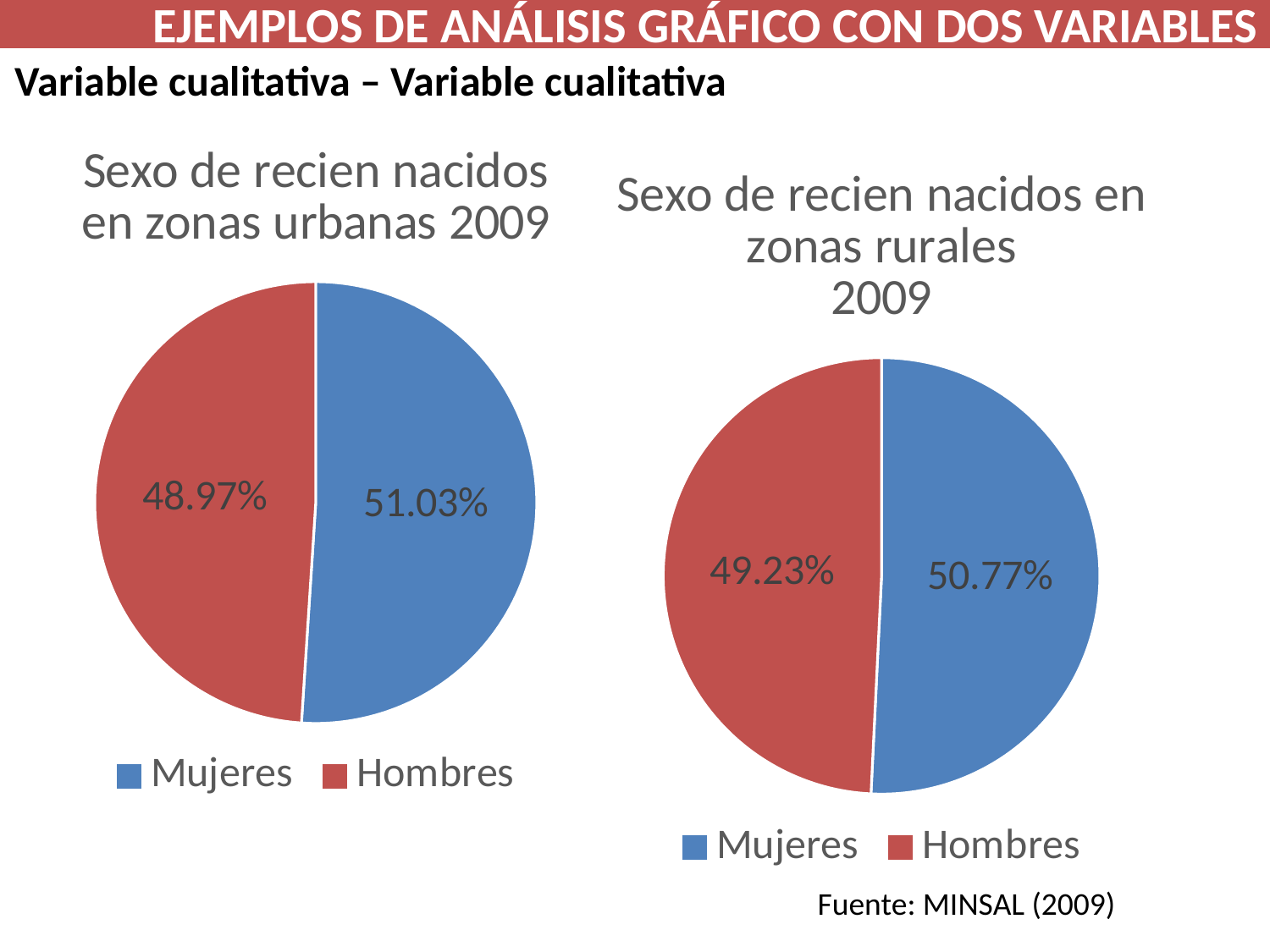
In the chart 'Sexo de recien nacidos en zonas rurales 2009', what is the difference between the Mujeres and Hombres shares? 1.54% How many categories does the legend of the chart 'Sexo de recien nacidos en zonas urbanas 2009' list? 2 In the chart 'Sexo de recien nacidos en zonas urbanas 2009', which category has the largest slice? Mujeres In the chart 'Sexo de recien nacidos en zonas urbanas 2009', what is the difference between the Mujeres and Hombres shares? 2.06% Is the Mujeres share larger in the urban chart (left) or the rural chart (right)? Urban chart (left) In the chart 'Sexo de recien nacidos en zonas rurales 2009', which colour represents Hombres? Red What kind of chart is 'Sexo de recien nacidos en zonas rurales 2009'? Pie chart In the chart 'Sexo de recien nacidos en zonas rurales 2009', what is the share for Hombres? 49.23% In the chart 'Sexo de recien nacidos en zonas rurales 2009', which category has the smallest slice? Hombres In the chart 'Sexo de recien nacidos en zonas urbanas 2009', what is the share for Mujeres? 51.03% In the chart 'Sexo de recien nacidos en zonas rurales 2009', what is the share for Mujeres? 50.77% In the chart 'Sexo de recien nacidos en zonas urbanas 2009', what is the share for Hombres? 48.97%